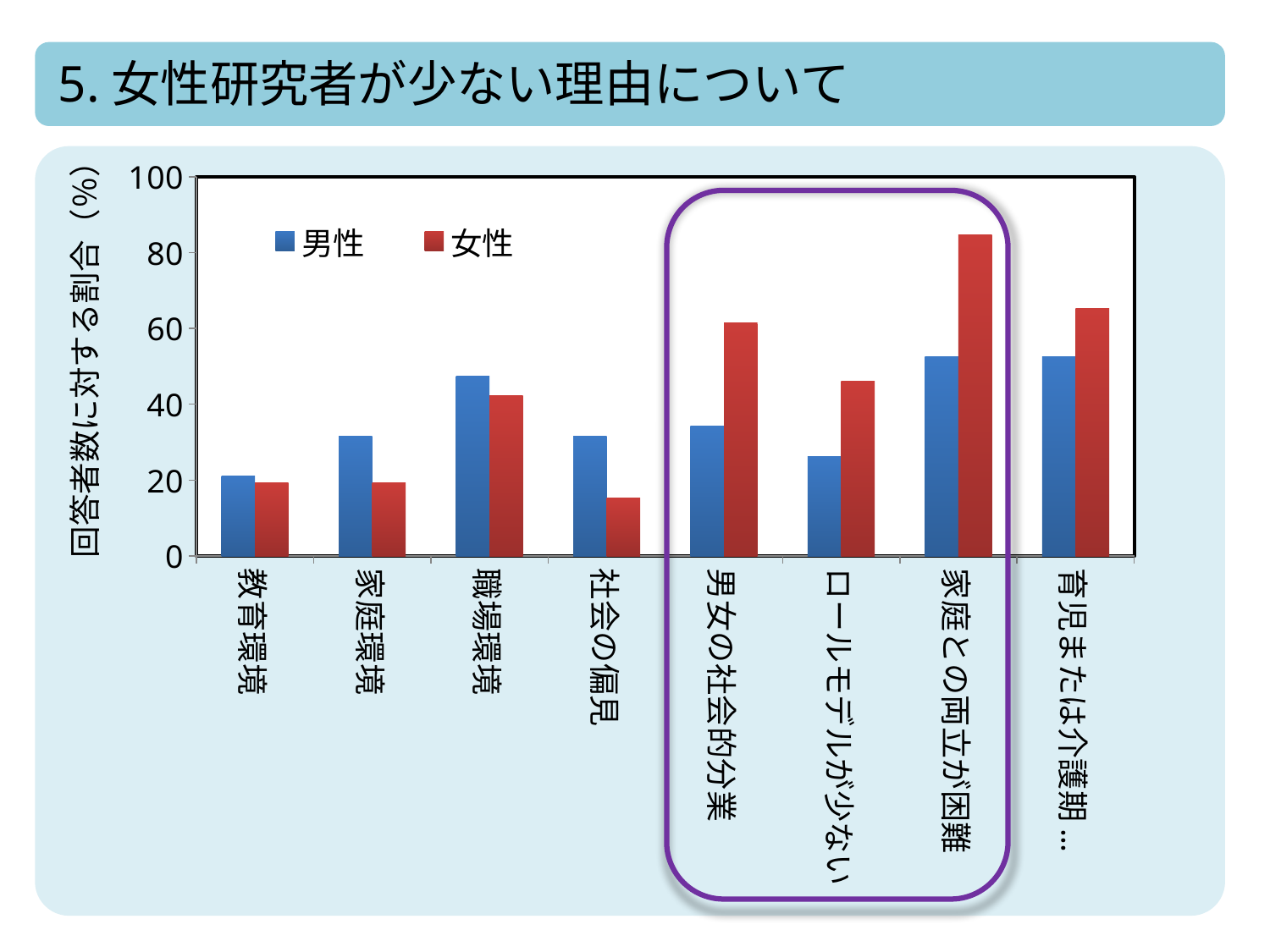
Is the 女性 value for 家庭との両立が困難 greater or less than 80? greater Is the 女性 value for 社会の偏見 greater or less than 20? less How many categories are shown on the x axis? 8 For the 女性 series, which category has the lowest value? 社会の偏見 For 男女の社会的分業, which series has the larger value, 男性 or 女性? 女性 For 家庭環境, which series has the larger value, 男性 or 女性? 男性 What colour represents the 女性 series in the chart? red What kind of chart is shown on the slide? bar chart Is the 男性 value for 職場環境 greater or less than 40? greater For the 男性 series, which category has the lowest value? 教育環境 How many series does the legend list? 2 For the 女性 series, which category has the highest value? 家庭との両立が困難